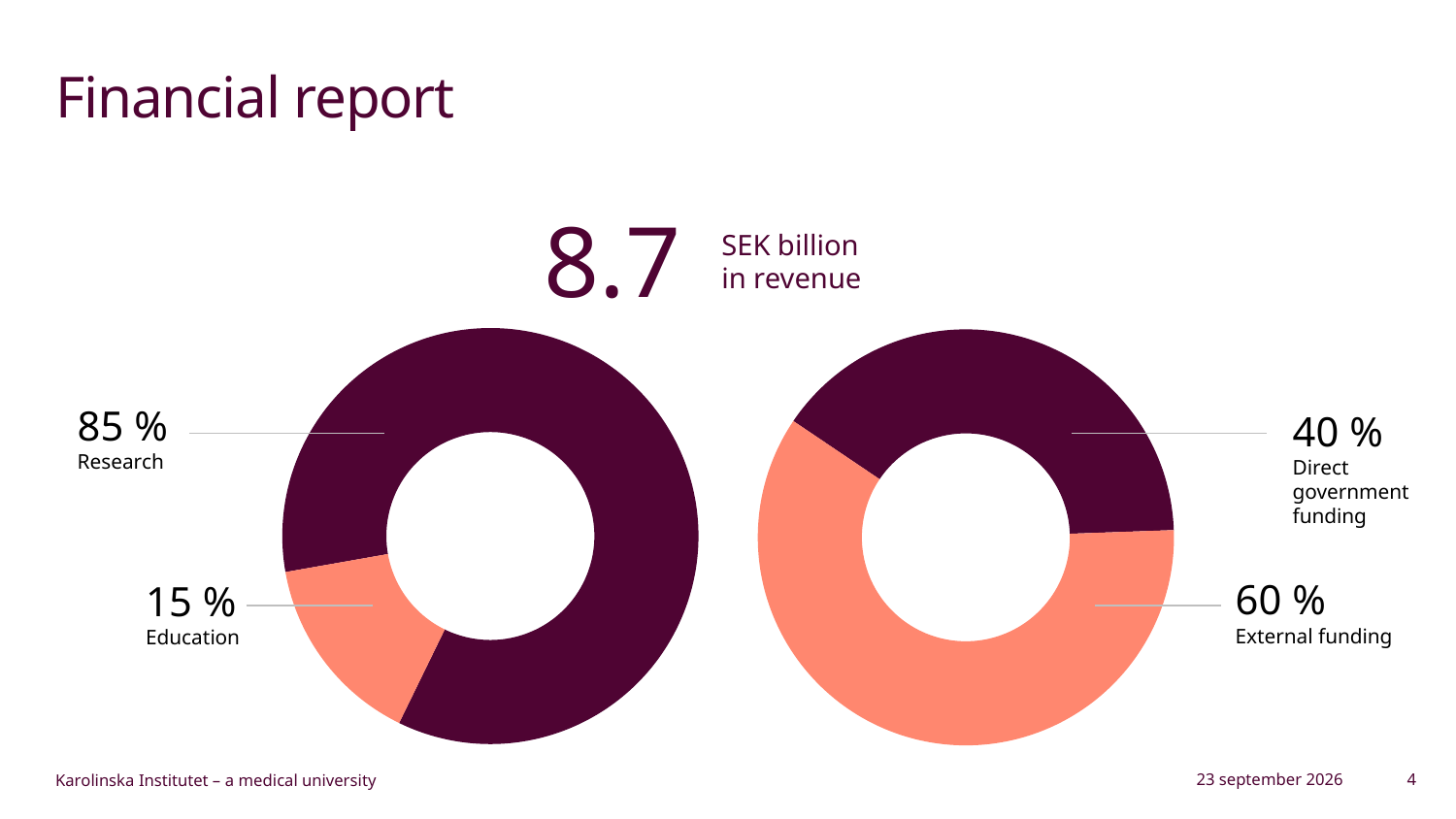
What kind of chart is used on this slide? Doughnut (pie) chart On the left chart, what share is labelled for Education? 15 % On the right chart, what is the difference in percentage points between External funding and Direct government funding? 20 How many categories does the left chart show? 2 On the left chart, which category has the largest share? Research What total revenue figure is shown above the charts? 8.7 SEK billion On the right chart, which is larger, External funding or Direct government funding? External funding On the right chart, what share is labelled for Direct government funding? 40 % On the right chart, which category has the smallest share? Direct government funding On the left chart, what is the difference in percentage points between Research and Education? 70 On the left chart, what share is labelled for Research? 85 % On the right chart, what share is labelled for External funding? 60 %